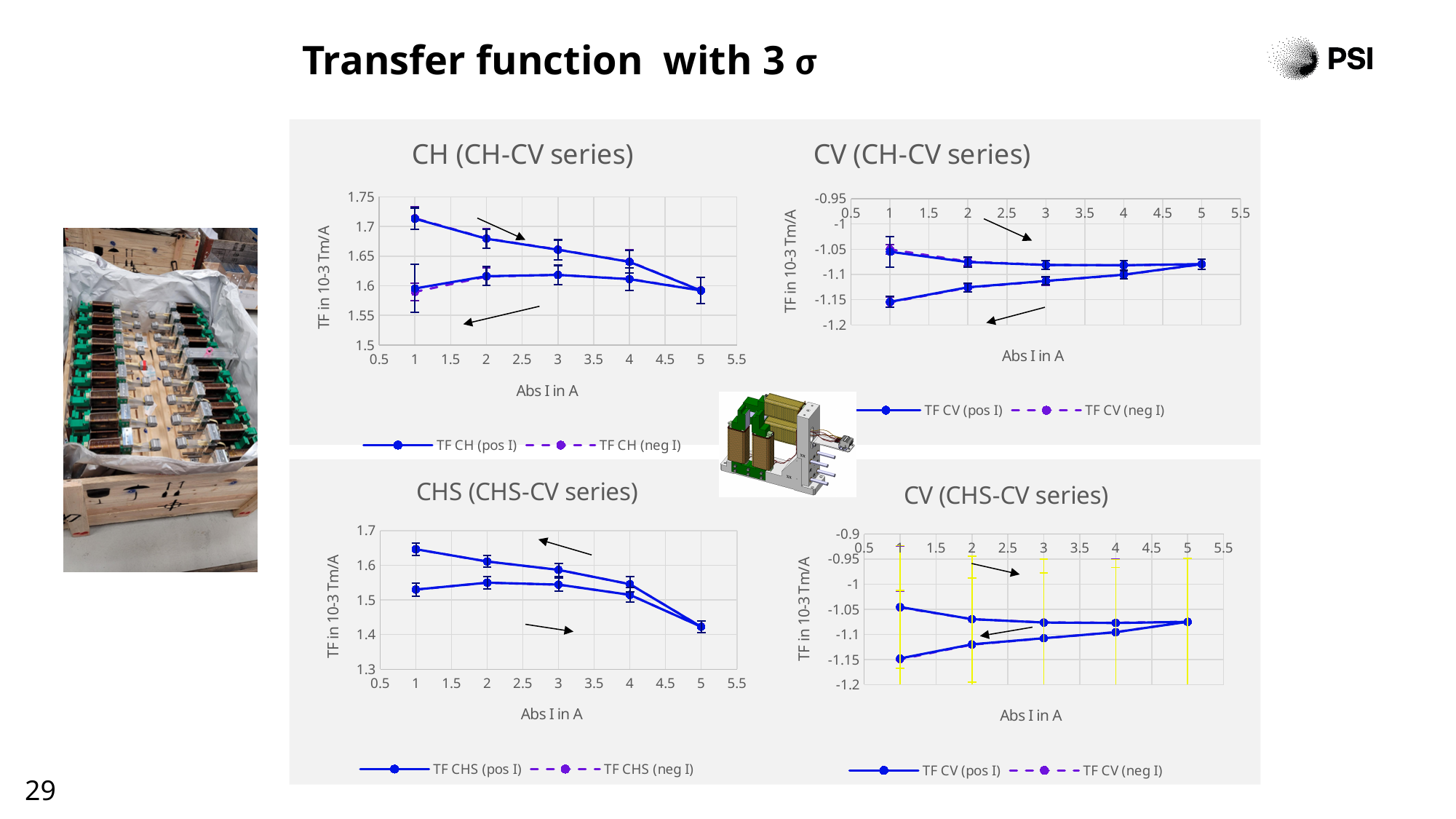
In the 'CH (CH-CV series)' chart, is the value of the upper curve at 1 A greater or less than 1.7? greater How many series does the legend of the 'CHS (CHS-CV series)' chart list? 2 What are the two legend entries of the 'CV (CH-CV series)' chart? TF CV (pos I) and TF CV (neg I) In the 'CHS (CHS-CV series)' chart, does the upper curve rise or fall as Abs I increases from 1 A to 5 A? fall In the 'CHS (CHS-CV series)' chart, is the value at 5 A greater or less than 1.5? less In the 'CHS (CHS-CV series)' chart, is the value of the upper curve at 1 A greater or less than 1.6? greater In the 'CH (CH-CV series)' chart, does the upper curve rise or fall as Abs I increases from 1 A to 5 A? fall What kind of chart is the 'CH (CH-CV series)' chart? line chart What is the x-axis label of the 'CV (CHS-CV series)' chart? Abs I in A In the 'CH (CH-CV series)' chart, how many data points are plotted along the upper curve? 5